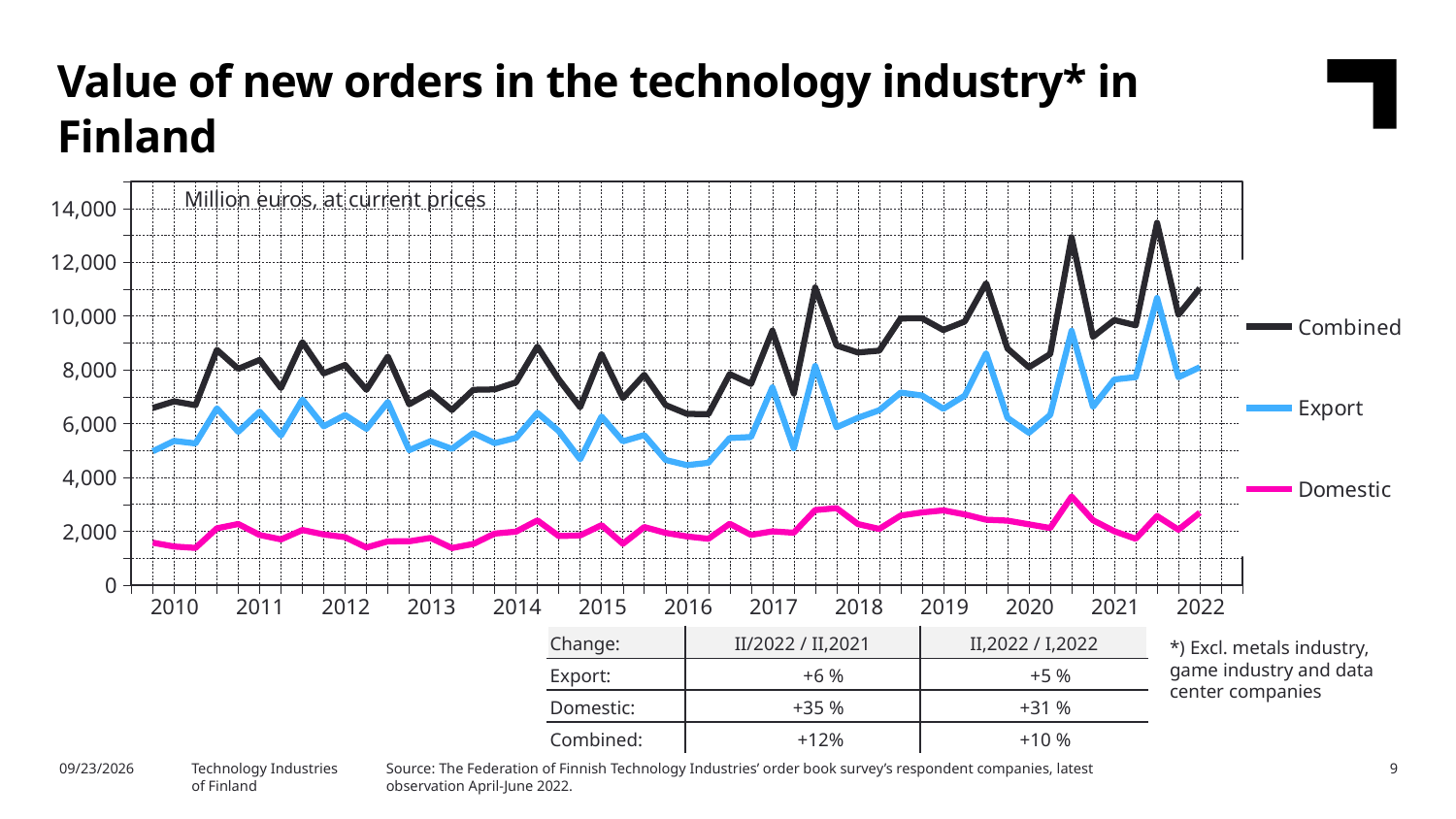
Is the Export value at the start of 2010 greater or less than 6,000? less How many series does the legend list? 3 What unit is stated at the top of the chart area? Million euros, at current prices Which series has the highest values throughout the chart? Combined According to the table below the chart, what is the Export change for II/2022 / II,2021? +6 % What kind of chart is shown on the slide? Line chart How many year labels appear on the x axis? 13 Is the Domestic value at the end of 2022 greater or less than 4,000? less What are the three series named in the legend? Combined, Export, Domestic Which series is larger at the start of 2010, Export or Domestic? Export Which series has the lowest values throughout the chart? Domestic Is the peak value of the Combined series in 2021 greater or less than 12,000? greater